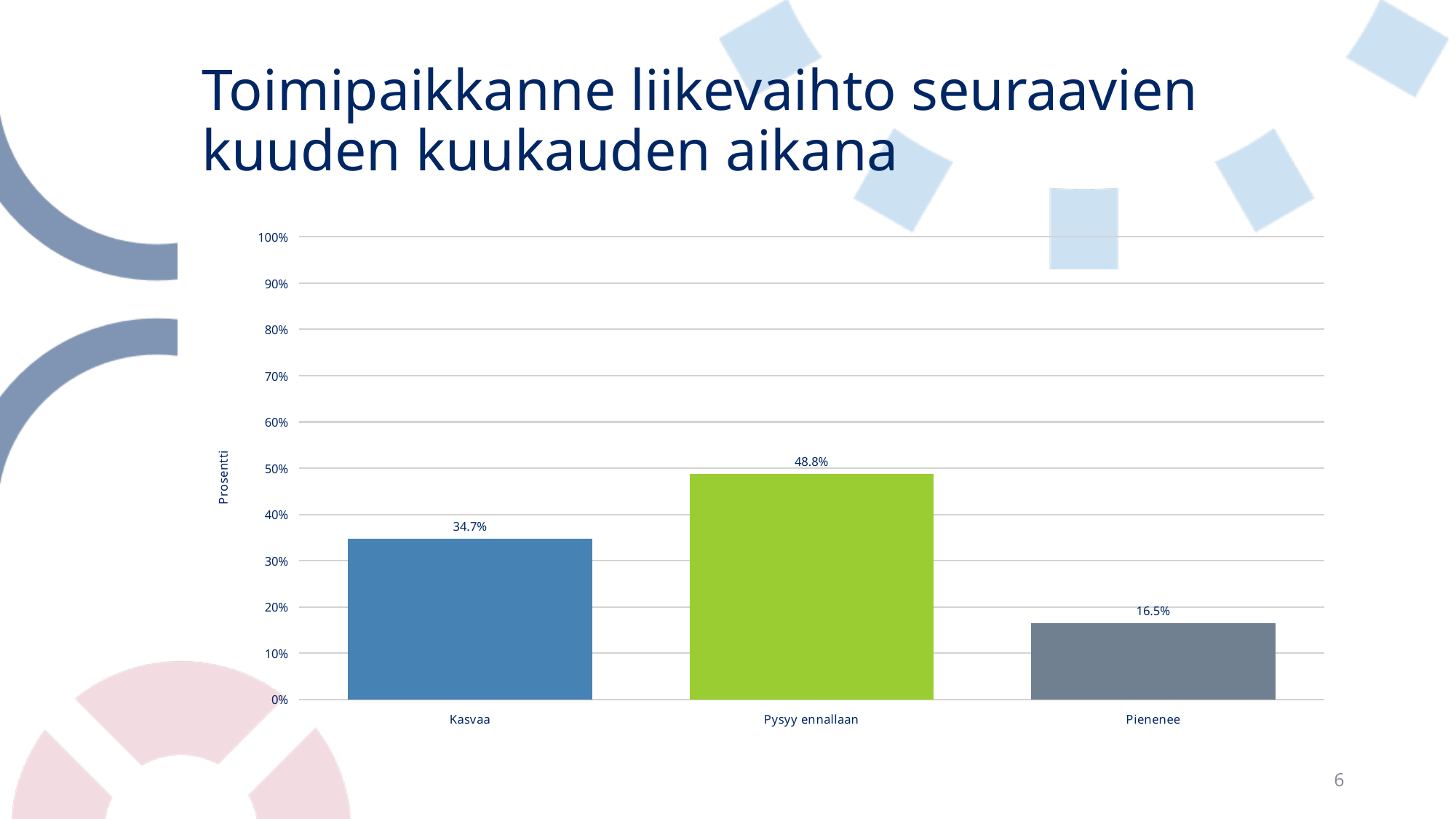
What is the label of the vertical axis? Prosentti What is the value for Pienenee? 16.5% Which category has the highest value? Pysyy ennallaan What is the difference between the values for Pysyy ennallaan and Kasvaa? 14.1% What is the value for Kasvaa? 34.7% Which category has the lowest value? Pienenee What kind of chart is shown on the slide? bar chart What is the value for Pysyy ennallaan? 48.8% Is the value for Pysyy ennallaan greater or less than 50%? less What is the difference between the values for Kasvaa and Pienenee? 18.2% How many categories are shown on the x axis? 3 Which is larger, the value for Kasvaa or the value for Pienenee? Kasvaa